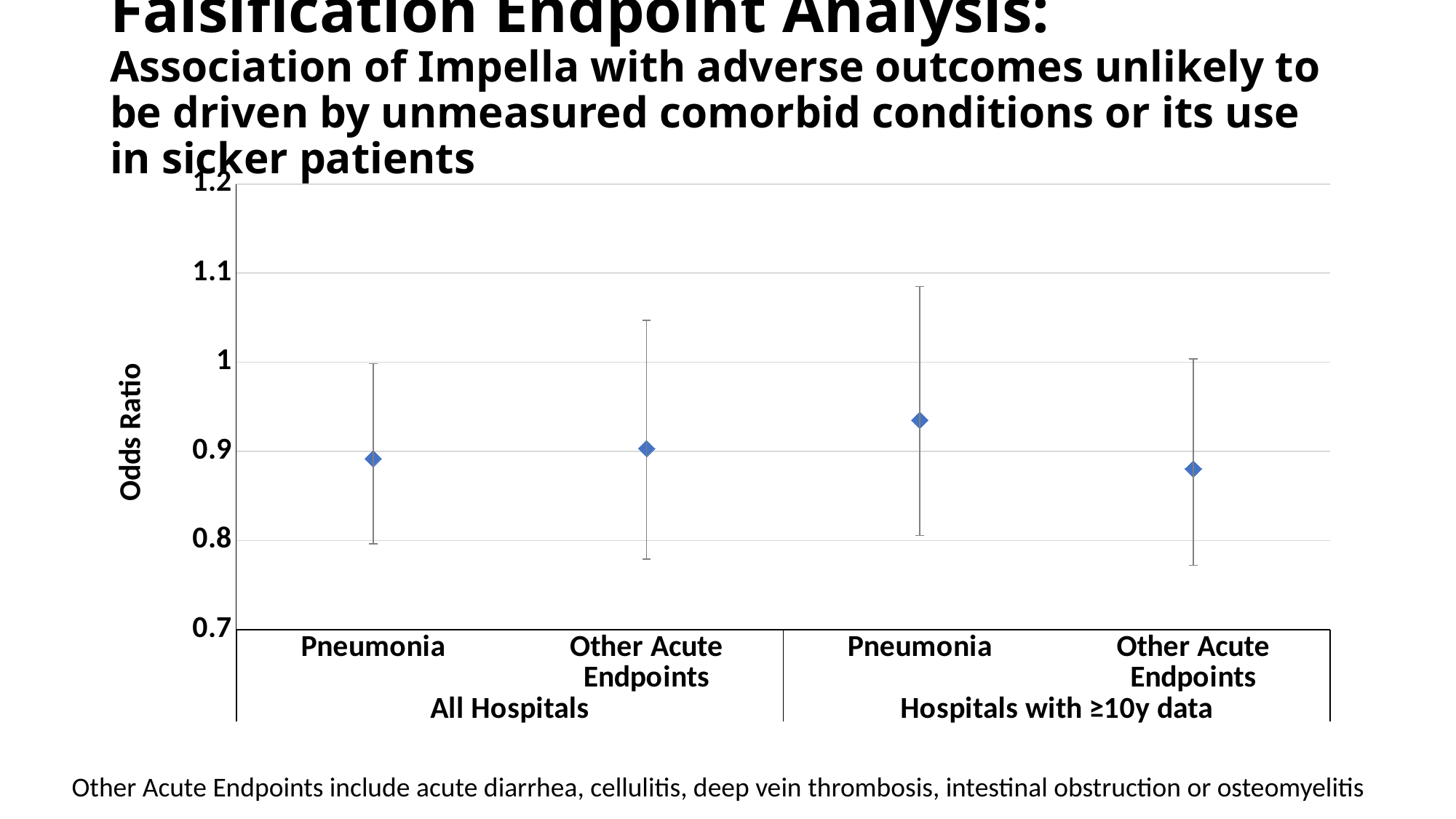
Is the odds ratio for Pneumonia in Hospitals with ≥10y data greater or less than 1? less Which is larger: the odds ratio for Pneumonia in All Hospitals or for Pneumonia in Hospitals with ≥10y data? Pneumonia in Hospitals with ≥10y data Which is larger: the odds ratio for Pneumonia or for Other Acute Endpoints in Hospitals with ≥10y data? Pneumonia Is the odds ratio for Other Acute Endpoints in Hospitals with ≥10y data greater or less than 0.9? less What is the lowest value shown on the vertical axis? 0.7 What is the label of the vertical axis? Odds Ratio Which plotted point has the highest odds ratio? Pneumonia (Hospitals with ≥10y data) What are the two hospital groups shown along the x axis? All Hospitals; Hospitals with ≥10y data What kind of chart is shown on the slide? Scatter (point) chart with error bars How many data points are plotted on the chart? 4 Is the odds ratio for Pneumonia in Hospitals with ≥10y data greater or less than 0.9? greater